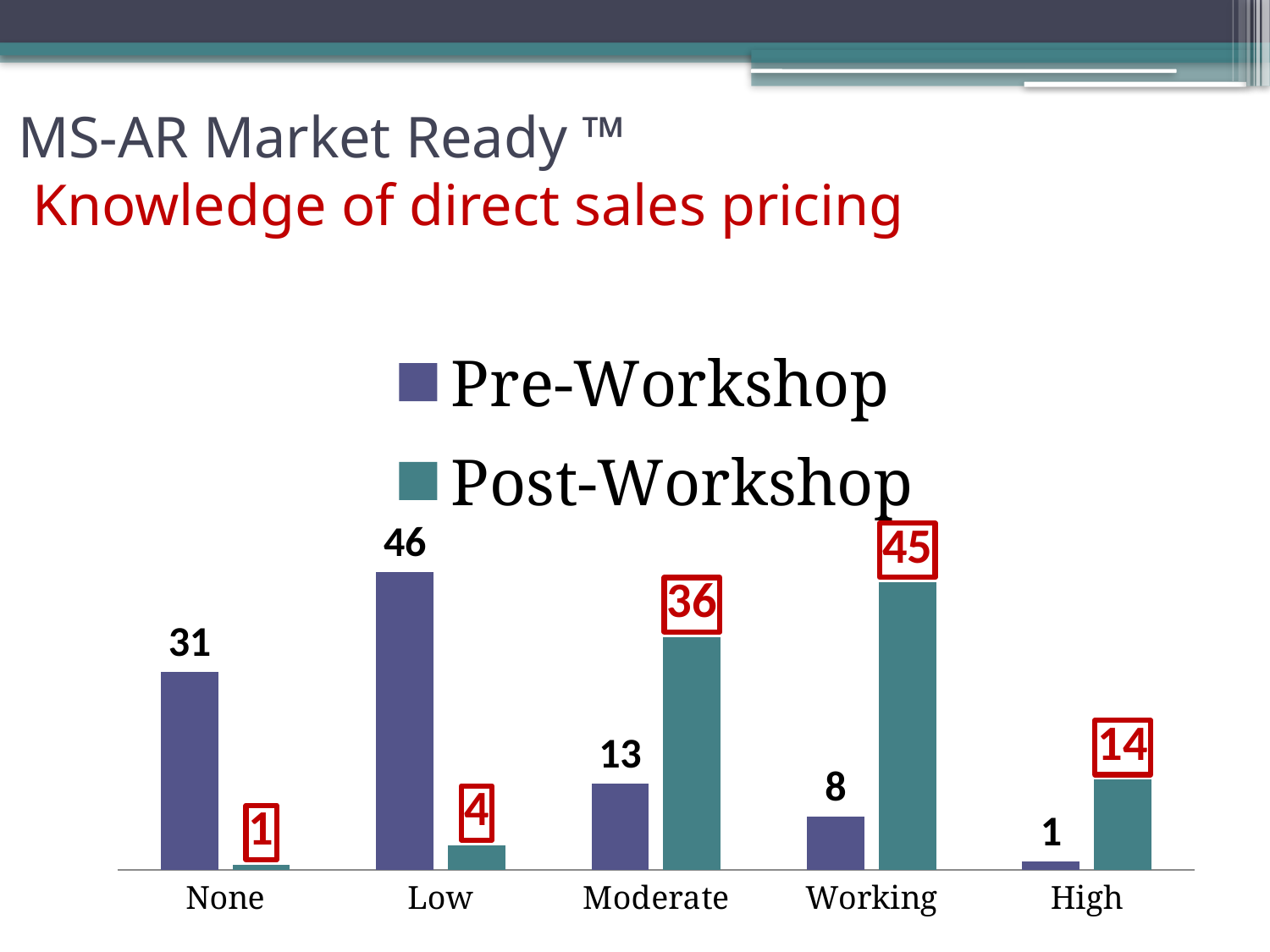
Which category has the lowest Post-Workshop value? None How many series does the legend list? 2 Which series is shown in teal in the legend? Post-Workshop What is the Post-Workshop value for the Working category? 45 What is the Pre-Workshop value for the Low category? 46 What is the Post-Workshop value for the None category? 1 Which is larger for the High category, the Pre-Workshop value or the Post-Workshop value? Post-Workshop How many categories are shown on the x axis? 5 Which category has the highest Pre-Workshop value? Low Do the Post-Workshop values rise or fall from None to Working? Rise What is the difference between the Post-Workshop and Pre-Workshop values for the Moderate category? 23 What kind of chart is shown on the slide? Bar chart